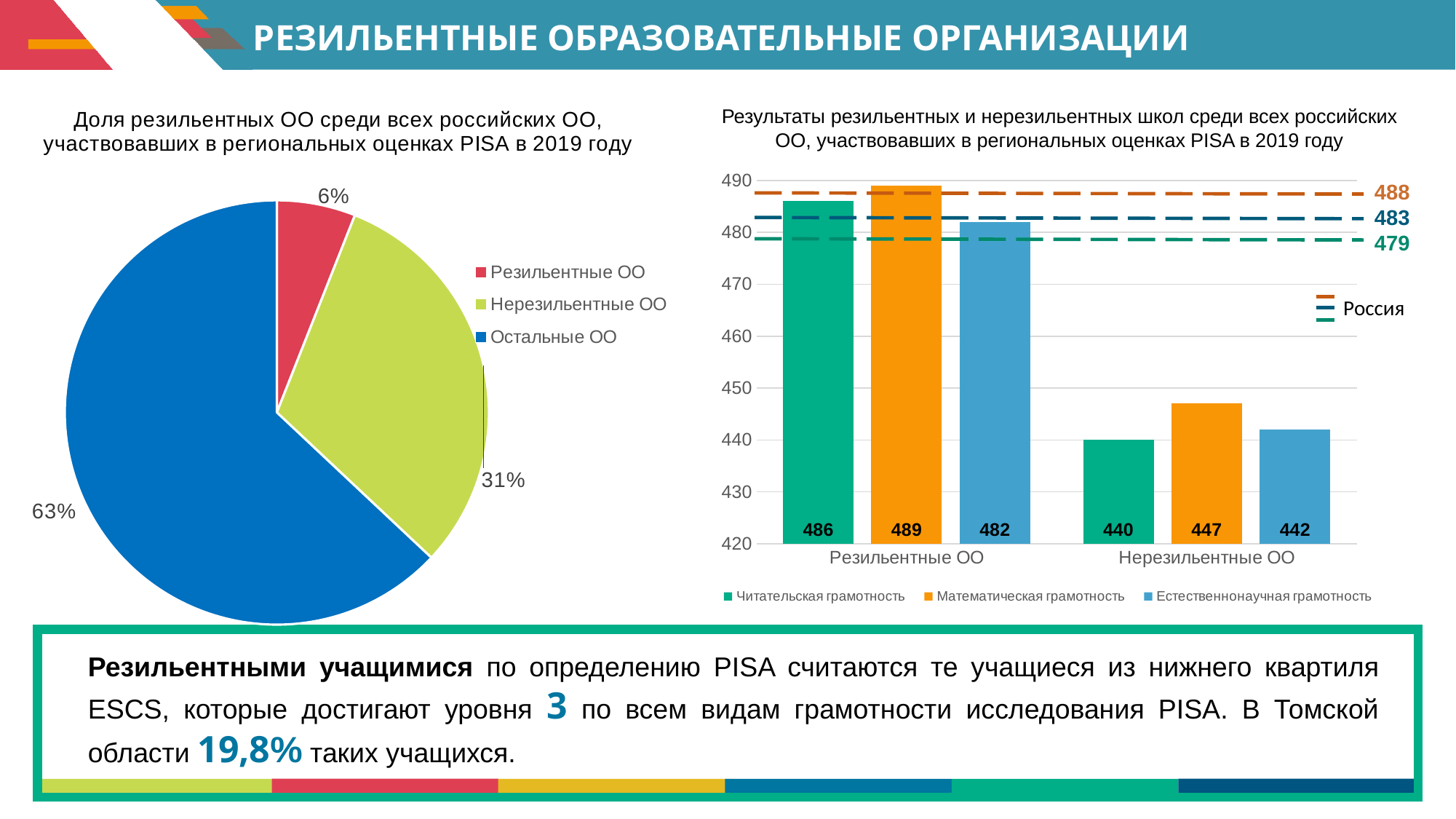
In the bar chart on the right, what is the value for Читательская грамотность for Нерезильентные ОО? 440 In the bar chart on the right, what is the value for Математическая грамотность for Резильентные ОО? 489 In the pie chart on the left, what share of the pie is labelled Резильентные ОО? 6% In the bar chart on the right, how many series does the legend list? 3 In the bar chart on the right, which bar has the lowest value? Читательская грамотность for Нерезильентные ОО (440) In the pie chart on the left, what share is labelled Остальные ОО? 63% In the pie chart on the left, which category has the largest slice? Остальные ОО In the bar chart on the right, what is the difference between Естественнонаучная грамотность for Резильентные ОО and for Нерезильентные ОО? 40 What type of chart is shown on the right side of the slide? Bar chart In the pie chart on the left, how many categories does the legend list? 3 In the bar chart on the right, which is larger: Математическая грамотность for Резильентные ОО or for Нерезильентные ОО? Резильентные ОО In the pie chart on the left, which category has the smallest slice? Резильентные ОО